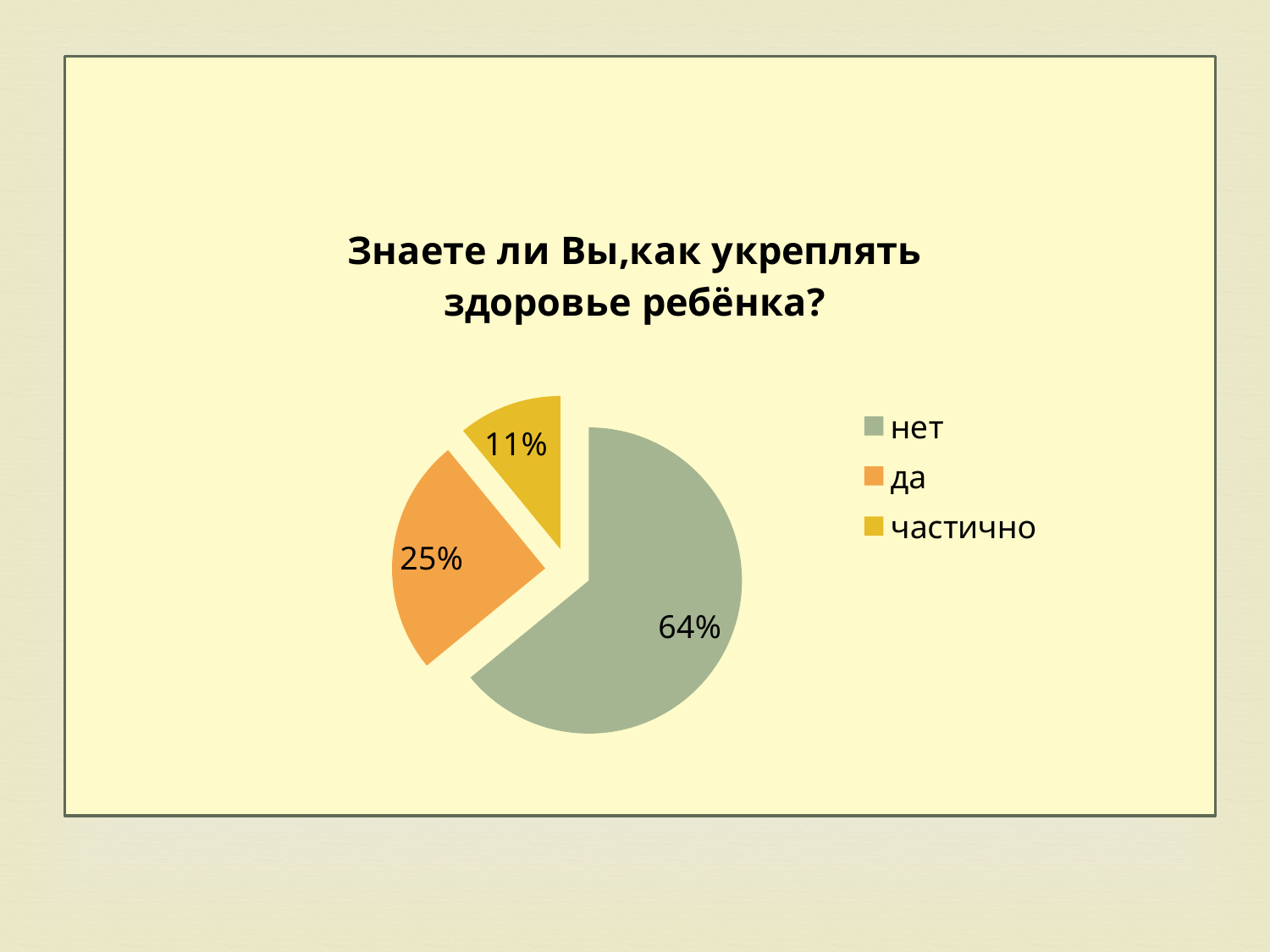
What percentage of the pie is labelled "частично"? 11% How many slices does the pie chart have? 3 How many entries does the legend list? 3 What colour is the slice for "частично"? yellow Which is larger, the share for "да" or the share for "частично"? да What is the difference in percentage points between "нет" and "да"? 39 Which category has the largest share of the pie? нет What percentage of the pie is labelled "нет"? 64% What type of chart is shown on the slide? pie chart What percentage of the pie is labelled "да"? 25% Which category has the smallest share of the pie? частично What is the title of the chart? Знаете ли Вы,как укреплять здоровье ребёнка?